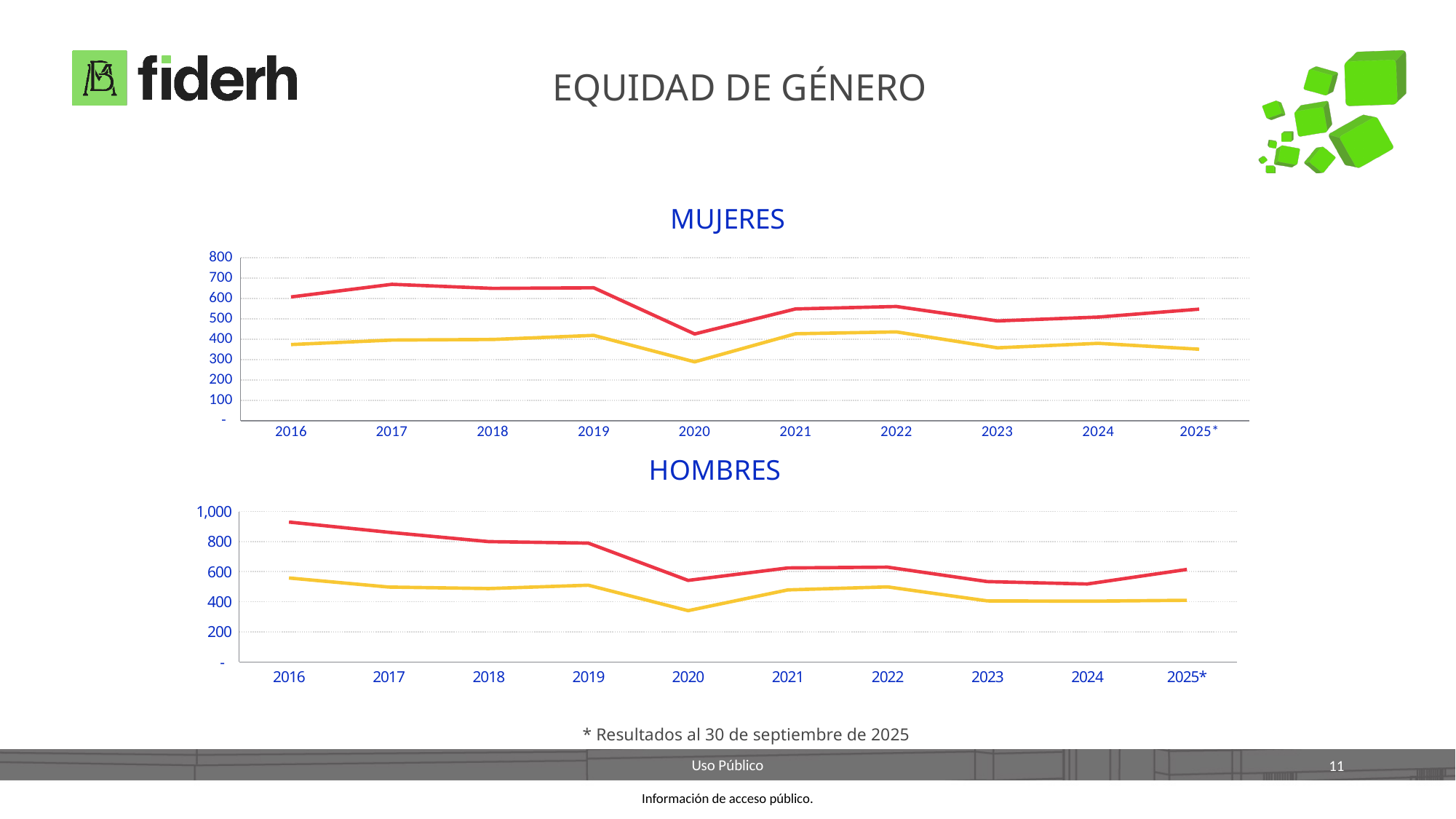
How many lines are plotted in the MUJERES chart? 2 In the HOMBRES chart, is the value of the yellow line in 2020 greater or less than 400? less In the HOMBRES chart, in which year does the yellow line reach its lowest value? 2020 How many years are shown on the x axis of the HOMBRES chart? 10 In the HOMBRES chart, in which year does the red line reach its highest value? 2016 In the MUJERES chart, is the value of the red line in 2020 greater or less than 500? less What kind of chart is the MUJERES chart? Line chart What are the titles of the two charts on the slide? MUJERES and HOMBRES In the MUJERES chart, is the value of the yellow line in 2020 greater or less than 400? less In the MUJERES chart, in which year does the red line reach its lowest value? 2020 In the HOMBRES chart, does the red line rise or fall from 2016 to 2019? Falls